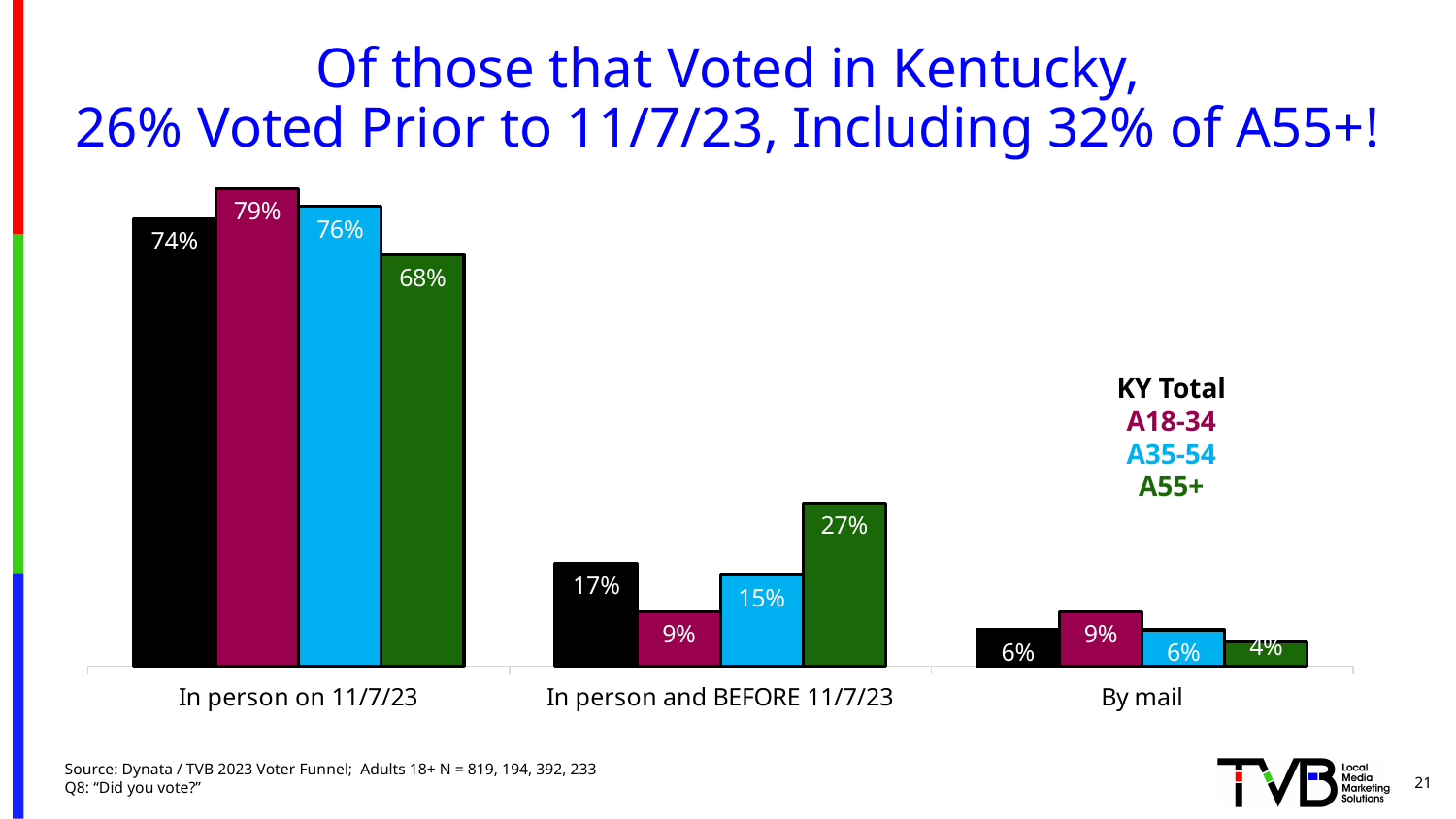
What kind of chart is shown on the slide? Bar chart What is the KY Total value for voting in person on 11/7/23? 74% Which colour represents the A35-54 series? Light blue How many series does the legend list? 4 What is the difference between the A55+ and A18-34 values for voting in person and BEFORE 11/7/23? 18 percentage points How many voting-method categories are shown on the x axis? 3 Which group has the lowest value for voting by mail? A55+ What is the difference between the KY Total values for voting in person on 11/7/23 and voting by mail? 68 percentage points Which is larger for voting in person on 11/7/23: the A35-54 value or the A55+ value? A35-54 What percentage of A55+ voted in person and BEFORE 11/7/23? 27% Which age group has the highest value for voting in person on 11/7/23? A18-34 What percentage of A18-34 voted by mail? 9%